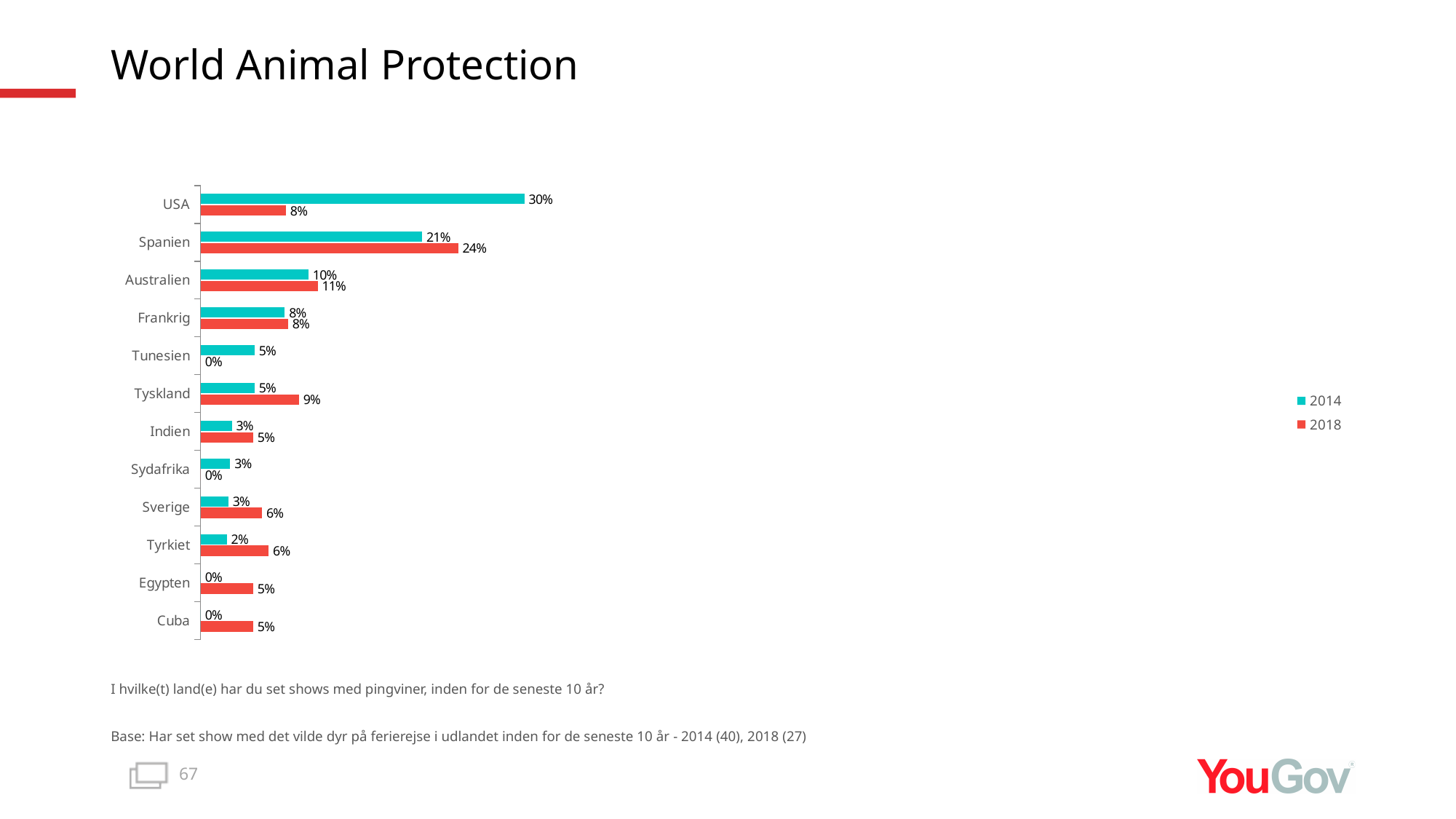
What is the 2018 value for Tyskland? 9% What is the difference between the 2014 and 2018 values for USA? 22 percentage points What is the 2014 value for USA? 30% What is the 2018 value for Tunesien? 0% What is the 2018 value for Spanien? 24% How many countries are shown on the chart? 12 Which is larger for Spanien, the 2014 value or the 2018 value? 2018 Which country has the highest 2014 value? USA Which colour represents the 2018 series in the legend? Red What kind of chart is shown on the slide? Bar chart Which country has the highest 2018 value? Spanien How many series does the legend list? 2